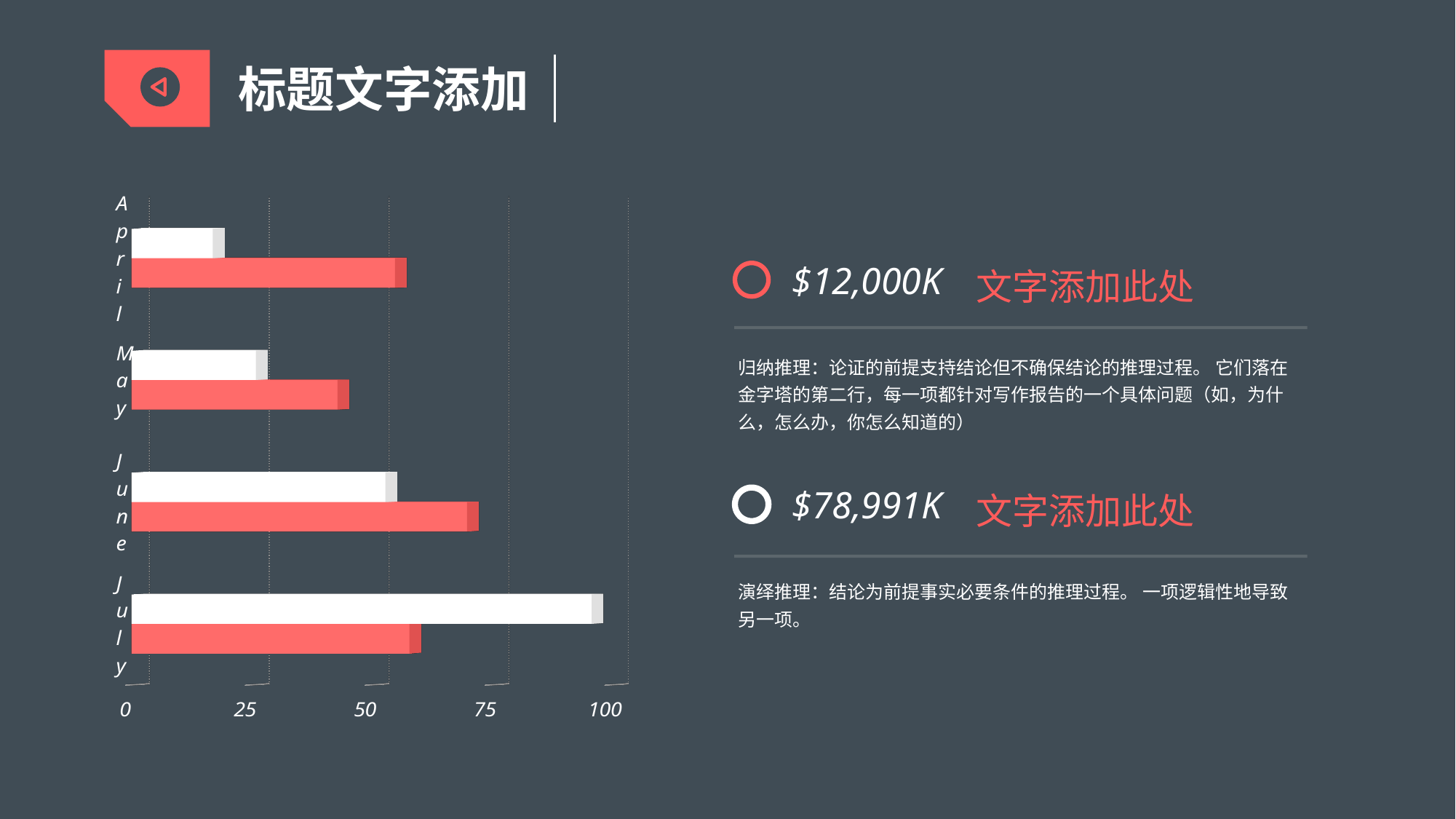
What is the highest value shown on the horizontal axis? 100 Is the red bar for April greater or less than 50? greater How many categories (months) are shown on the chart? 4 Which month has the longest white bar? July For July, which bar is longer, the white bar or the red bar? white bar For April, which bar is longer, the white bar or the red bar? red bar Is the white bar for May greater or less than 50? less Which month has the shortest red bar? May What kind of chart is shown on the slide? bar chart Which month has the longest red bar? June Which month has the shortest white bar? April Is the white bar for July greater or less than 75? greater